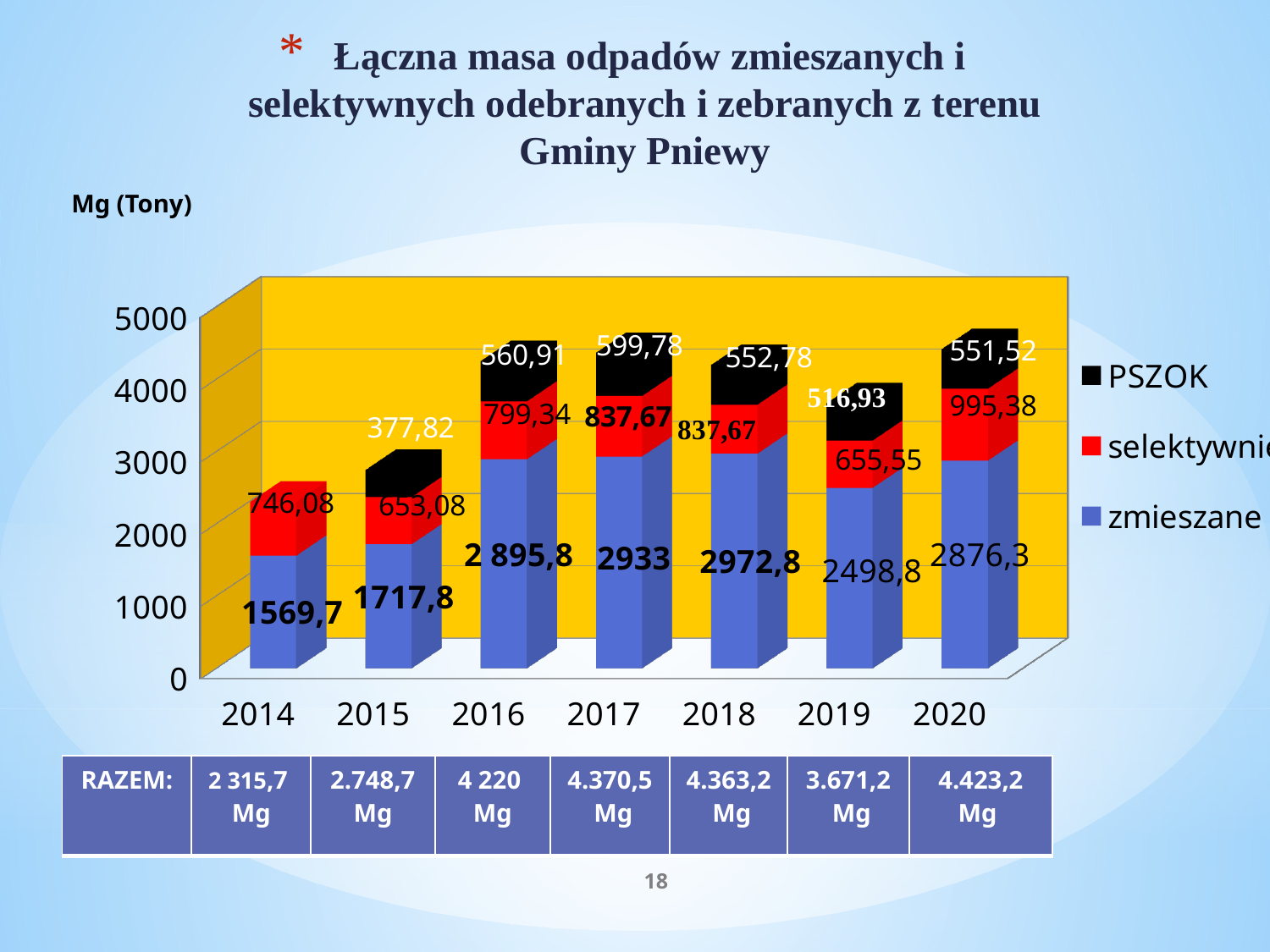
How many series does the legend list? 3 What is the total (RAZEM) for 2020? 4.423,2 Mg What is the selektywnie value for 2020? 995,38 What kind of chart is shown on the slide? Stacked bar chart What is the PSZOK value for 2017? 599,78 Which year has the highest PSZOK value? 2017 Which year has the larger zmieszane value, 2016 or 2017? 2017 What is the difference between the selektywnie values for 2020 and 2019? 339,83 Which year has the lowest zmieszane value? 2014 How many years are shown on the x axis? 7 Which year has the highest zmieszane value? 2018 What is the value of the zmieszane series for 2018? 2972,8